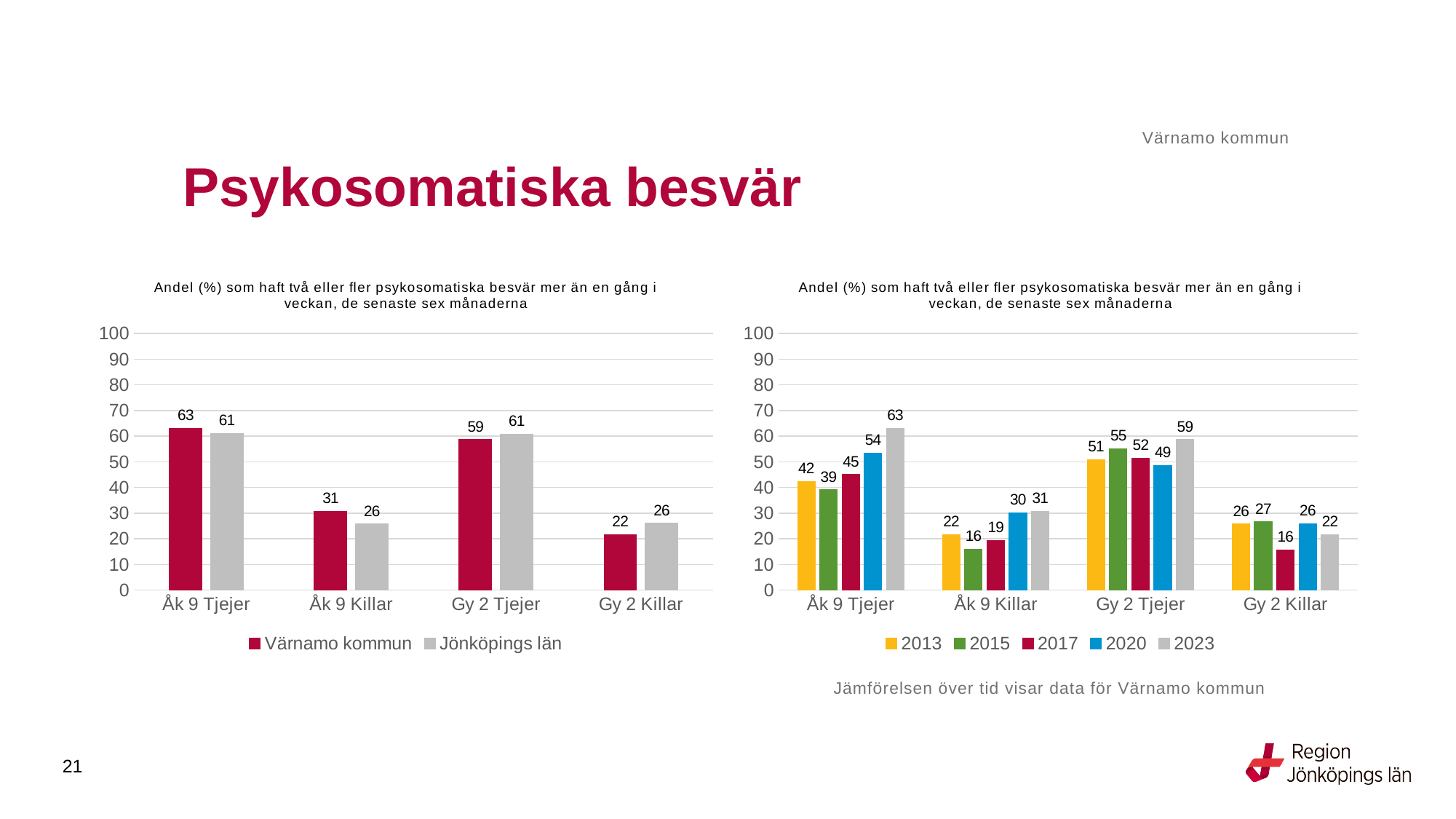
How many series does the legend of the left chart list? 2 In the left chart, what is the difference between Värnamo kommun and Jönköpings län for Åk 9 Killar? 5 In the left chart, which is larger for Gy 2 Tjejer: Värnamo kommun or Jönköpings län? Jönköpings län In the left chart, what is the value for Jönköpings län for Gy 2 Killar? 26 How many series does the legend of the right chart list? 5 In the right chart, what is the value for 2020 for Åk 9 Tjejer? 54 In the left chart, which category has the lowest value for Värnamo kommun? Gy 2 Killar In the left chart, what is the value for Värnamo kommun for Åk 9 Tjejer? 63 What type of chart is the right chart? Bar chart In the right chart, what is the value for 2015 for Åk 9 Killar? 16 In the right chart, what is the difference between 2023 and 2013 for Åk 9 Tjejer? 21 In the right chart, which year has the highest value for Gy 2 Tjejer? 2023